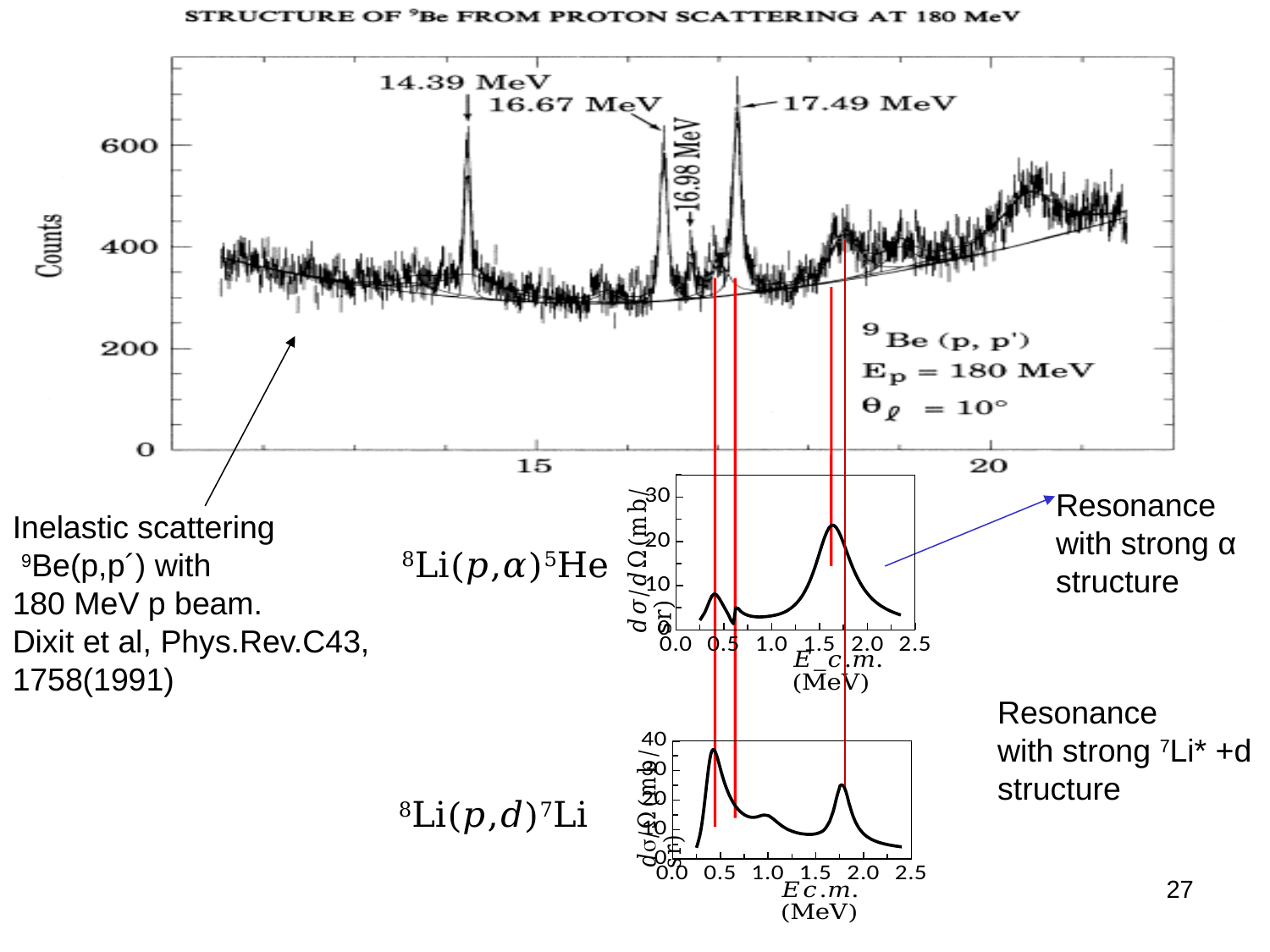
In the top chart (Structure of 9Be from proton scattering), how many peaks are labelled with an energy in MeV? 4 What is the title of the large chart at the top of the slide? STRUCTURE OF 9Be FROM PROTON SCATTERING AT 180 MeV In the 8Li(p,α)5He chart, is the cross section at the peak near 1.6 MeV greater or less than 20 mb/sr? greater In the top chart (Structure of 9Be from proton scattering), what is the label of the y axis? Counts In the top chart (Structure of 9Be from proton scattering), which of the two labelled peaks is higher, 14.39 MeV or 16.98 MeV? 14.39 MeV In the top chart (Structure of 9Be from proton scattering), what kind of chart is shown? line chart In the 8Li(p,d)7Li chart, is the cross section at the peak near 0.5 MeV greater or less than 30 mb/sr? greater In the 8Li(p,α)5He chart, which peak is higher, the one near 0.4 MeV or the one near 1.6 MeV? the one near 1.6 MeV In the top chart (Structure of 9Be from proton scattering), is the peak count at 17.49 MeV greater or less than 600? greater In the top chart (Structure of 9Be from proton scattering), which labelled peak reaches the lowest number of counts? 16.98 MeV In the top chart (Structure of 9Be from proton scattering), which labelled peak reaches the highest number of counts? 17.49 MeV